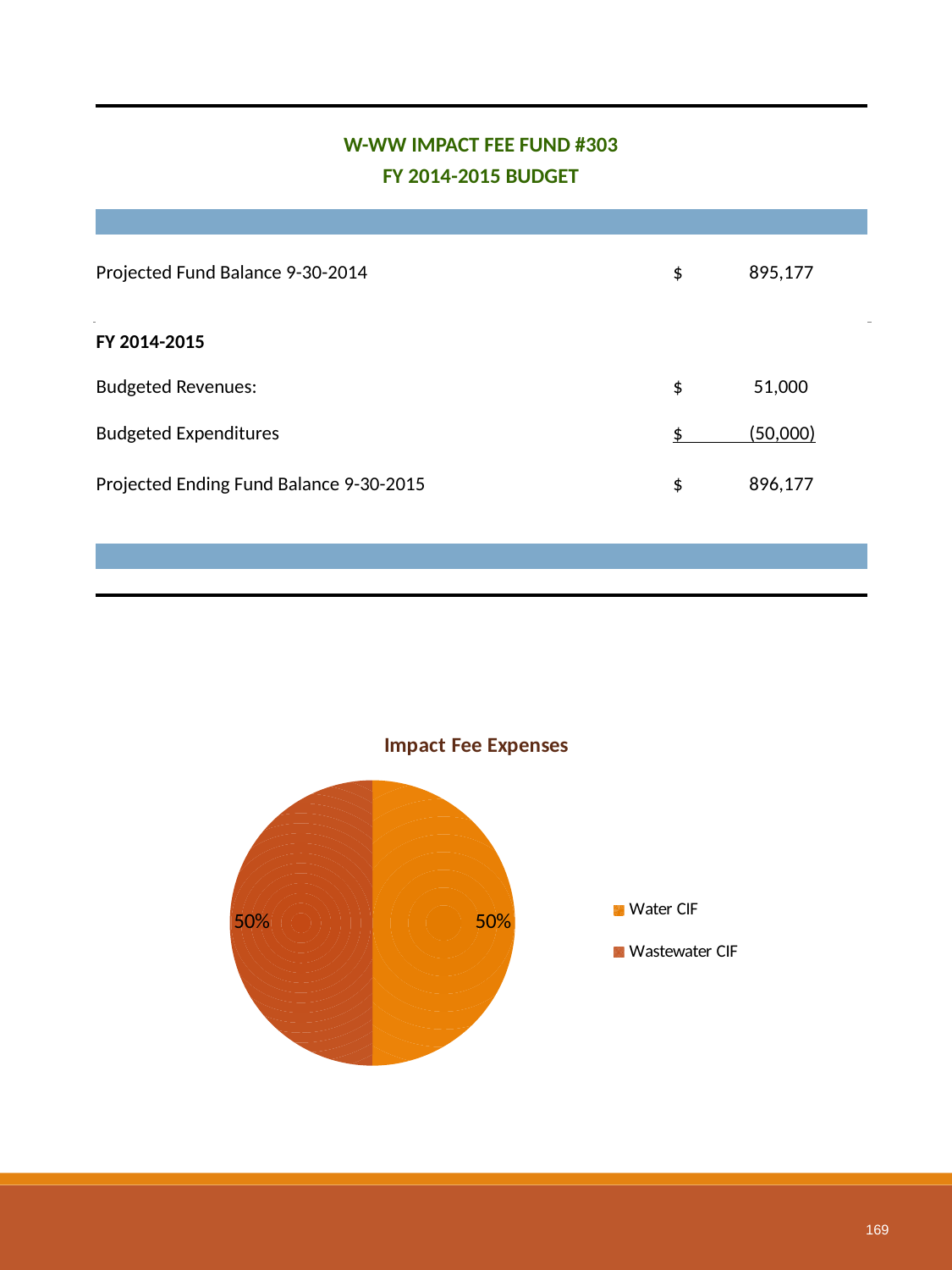
Which legend entry in the Impact Fee Expenses chart is shown in orange? Water CIF What share of the Impact Fee Expenses pie is Wastewater CIF? 50% How many entries does the legend of the Impact Fee Expenses chart list? 2 What share of the Impact Fee Expenses pie is Water CIF? 50% How many slices does the Impact Fee Expenses pie chart have? 2 What value is labelled on the Water CIF slice of the Impact Fee Expenses chart? 50% What is the title of the pie chart? Impact Fee Expenses What value is labelled on the Wastewater CIF slice of the Impact Fee Expenses chart? 50% What is the difference between the Water CIF and Wastewater CIF shares in the Impact Fee Expenses chart? 0% What do the Water CIF and Wastewater CIF shares in the Impact Fee Expenses chart add up to? 100% What kind of chart is shown on the slide? pie chart